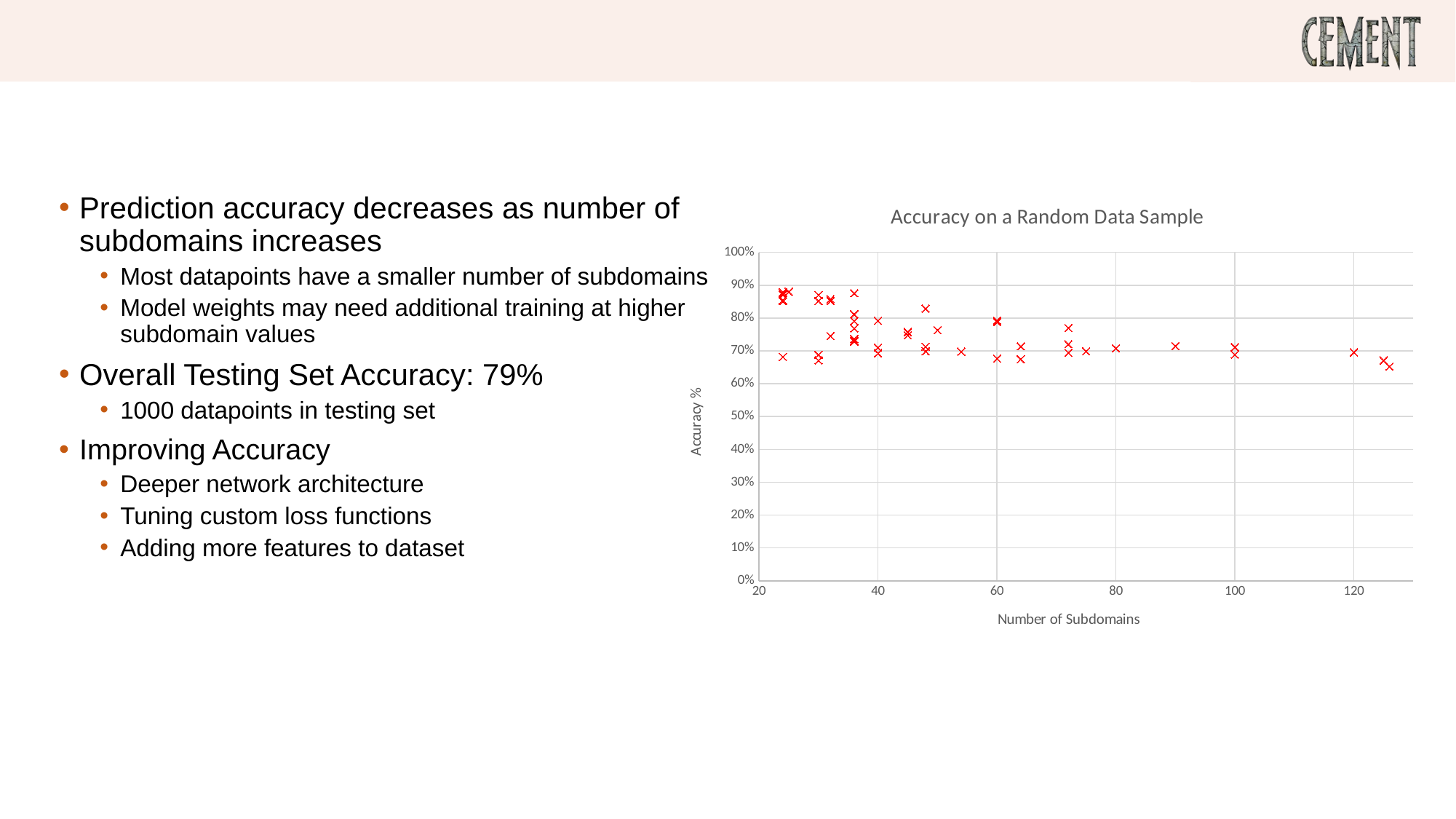
What is the largest value shown on the x axis of the chart? 120 Is the accuracy of the point at roughly 125 subdomains greater or less than 70%? less Are any points on the chart plotted above 90% accuracy? No Is the highest accuracy value plotted on the chart greater or less than 80%? greater Do the accuracy values generally rise or fall as the number of subdomains increases? Fall What kind of chart is shown on the slide? Scatter chart What is the title of the chart? Accuracy on a Random Data Sample What is the label of the x axis of the chart? Number of Subdomains Which has the higher accuracy: the point at roughly 125 subdomains or the highest point at roughly 24 subdomains? The point at roughly 24 subdomains